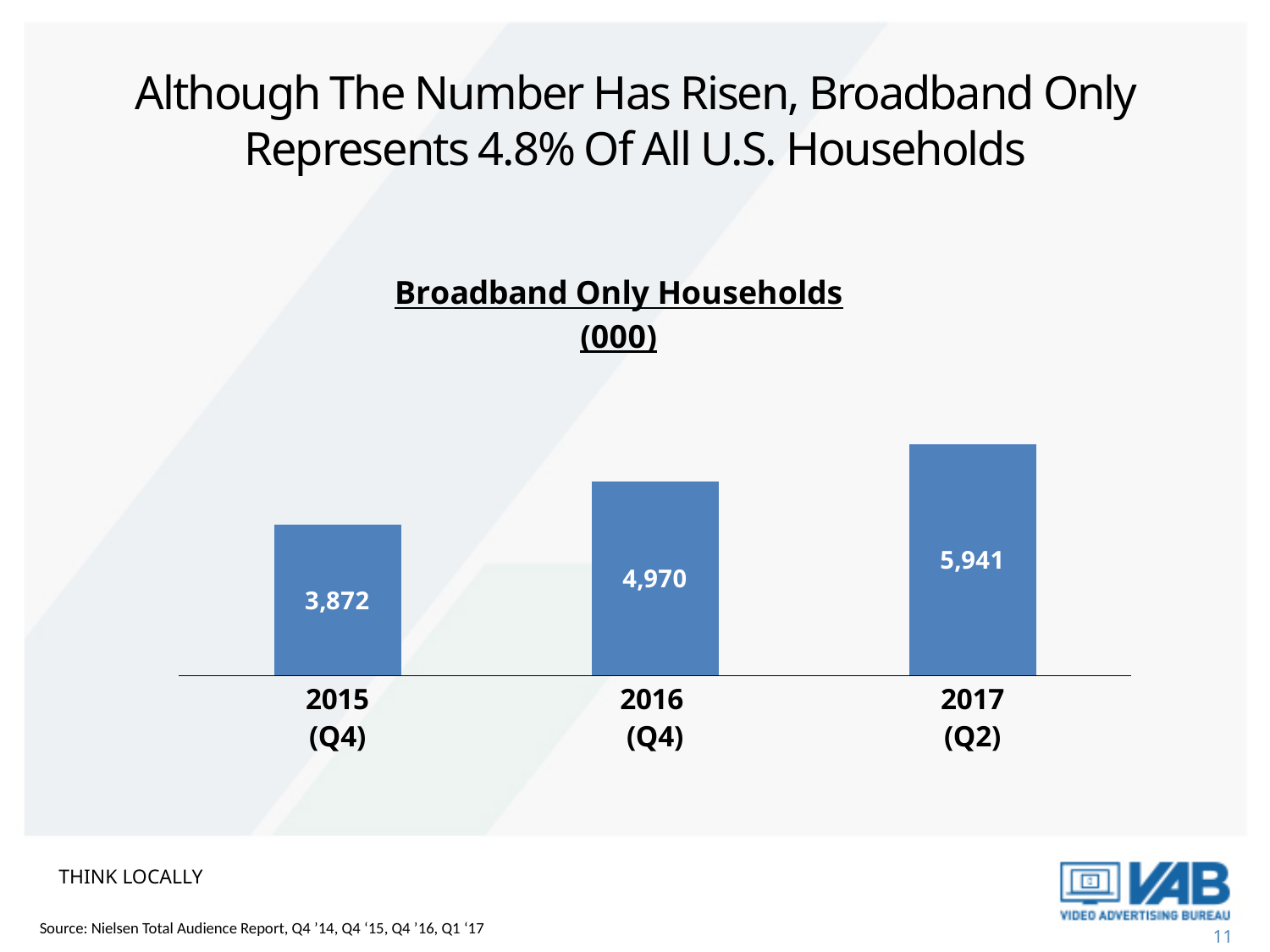
Do the values in the Broadband Only Households chart rise or fall from 2015 (Q4) to 2017 (Q2)? Rise Which is larger in the Broadband Only Households chart: the value for 2016 (Q4) or 2017 (Q2)? 2017 (Q2) What is the value for 2016 (Q4) in the Broadband Only Households chart? 4,970 What is the difference between the 2016 (Q4) and 2015 (Q4) values in the Broadband Only Households chart? 1,098 What kind of chart is used to show Broadband Only Households? Bar chart Which period has the highest number of Broadband Only Households? 2017 (Q2) Which period has the lowest number of Broadband Only Households? 2015 (Q4) What is the value for 2017 (Q2) in the Broadband Only Households chart? 5,941 How many periods are shown in the Broadband Only Households chart? 3 In what units are the values in the Broadband Only Households chart expressed, according to the chart title? (000) What is the difference between the 2017 (Q2) and 2015 (Q4) values in the Broadband Only Households chart? 2,069 What is the value for 2015 (Q4) in the Broadband Only Households chart? 3,872